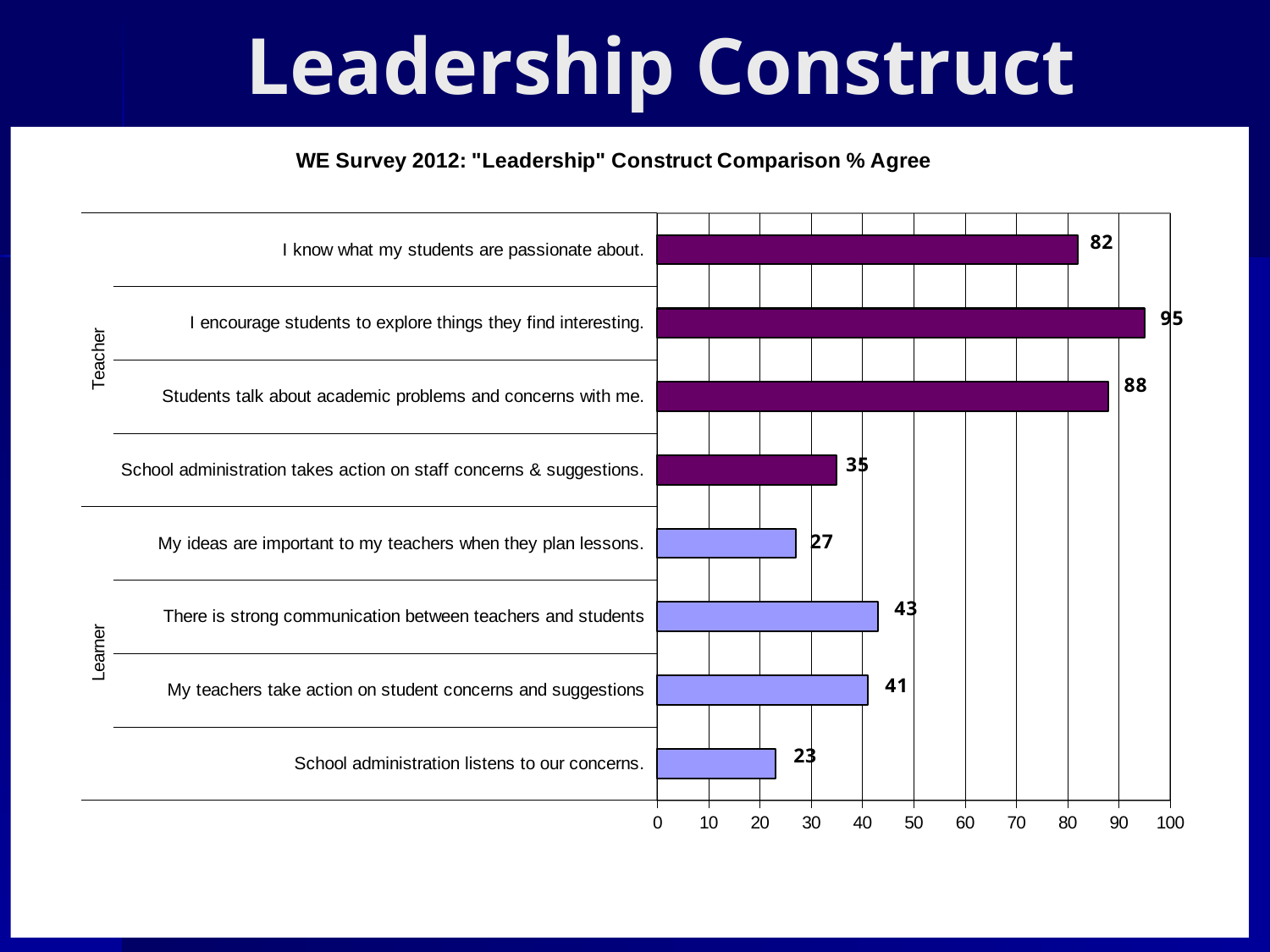
What is the value for "School administration listens to our concerns."? 23 How many items are plotted in the chart? 8 What is the title of the chart? WE Survey 2012: "Leadership" Construct Comparison % Agree Is the value for "School administration takes action on staff concerns & suggestions." greater or less than 40? less Which is larger: "My teachers take action on student concerns and suggestions" or "My ideas are important to my teachers when they plan lessons."? My teachers take action on student concerns and suggestions Which item has the lowest value? School administration listens to our concerns. What is the value for "I know what my students are passionate about."? 82 What is the difference between "Students talk about academic problems and concerns with me." and "School administration takes action on staff concerns & suggestions."? 53 What kind of chart is shown? Bar chart Which item has the highest value? I encourage students to explore things they find interesting. What is the value for "There is strong communication between teachers and students"? 43 What are the two groups the items are divided into on the vertical axis? Teacher and Learner